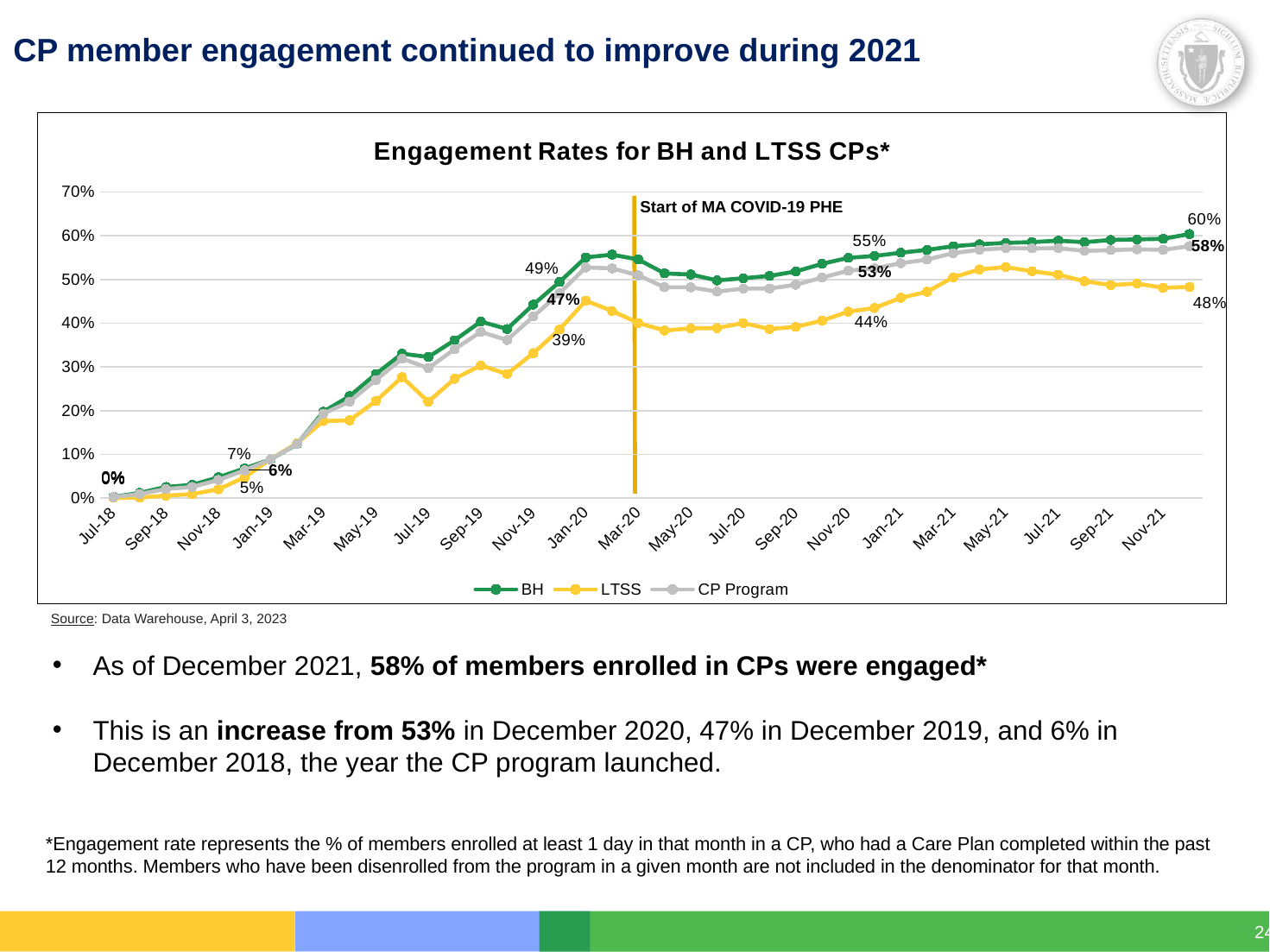
What kind of chart is shown on the slide? line chart What is the CP Program engagement rate labelled for December 2018? 6% What is the difference between the BH and LTSS engagement rates at the end of the chart (60% vs 48%)? 12 percentage points How many series does the legend of the chart list? 3 What is the BH engagement rate at the end of the chart (Dec-21)? 60% What event does the vertical line on the chart mark? Start of MA COVID-19 PHE What is the CP Program engagement rate labelled for December 2020? 53% Which series has the highest engagement rate at the end of the chart? BH Is the BH engagement rate in Jan-20 greater or less than 50%? greater What is the LTSS engagement rate at the end of the chart (Dec-21)? 48% By how much did the CP Program engagement rate rise from December 2020 (53%) to December 2021 (58%)? 5 percentage points In December 2019, which series had the higher engagement rate, BH or LTSS? BH